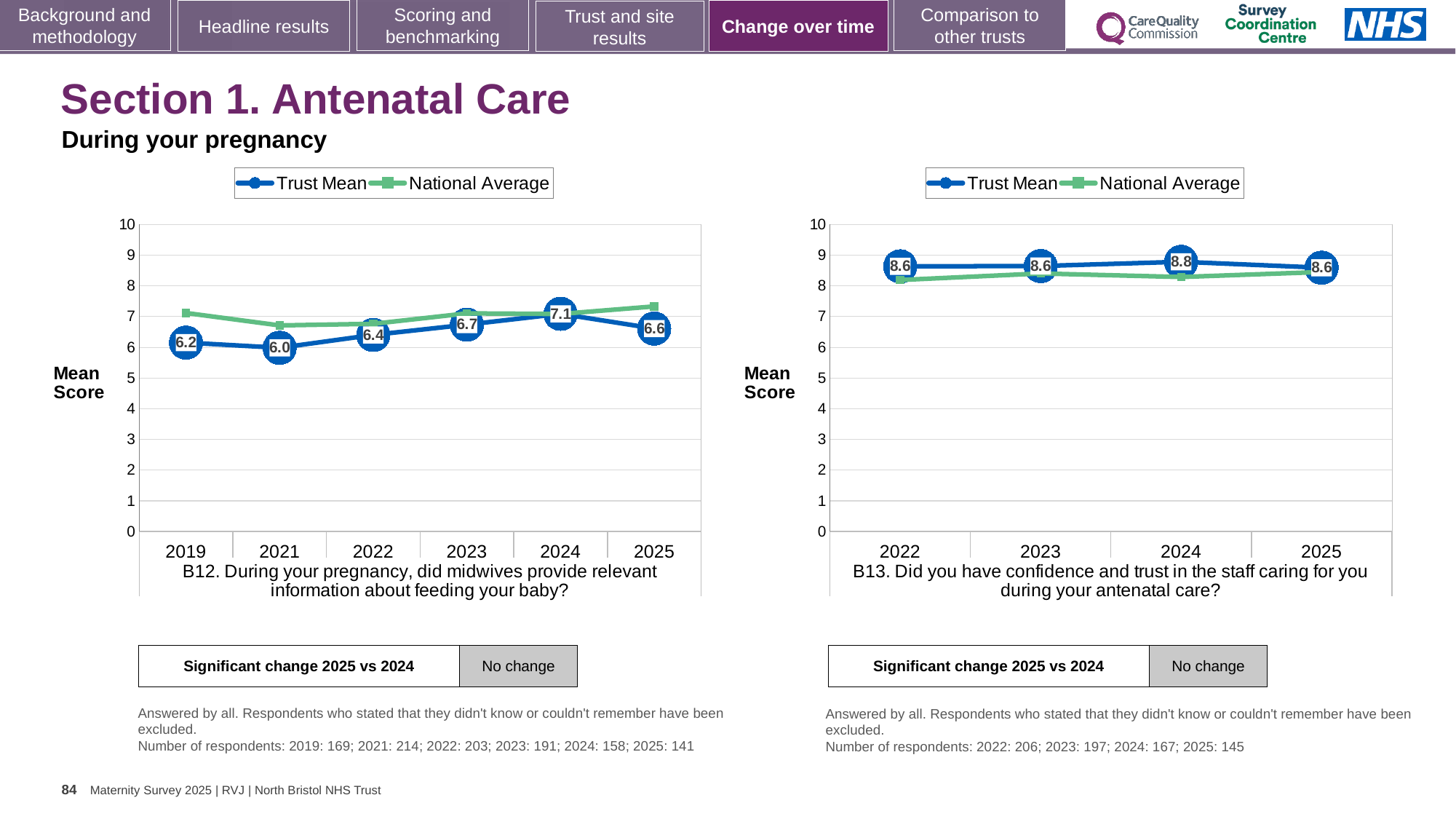
In the B13 chart (right), is the National Average for 2022 greater or less than 9? less In the B13 chart (right), which year has the highest Trust Mean score? 2024 In the B12 chart (left), what is the Trust Mean score for 2024? 7.1 In the B13 chart (right), how many series does the legend list? 2 In the B12 chart (left), what is the Trust Mean score for 2021? 6.0 In the B12 chart (left), is the National Average for 2019 greater or less than 6? greater In the B13 chart (right), what is the Trust Mean score for 2024? 8.8 In the B12 chart (left), how many years are shown on the x axis? 6 What kind of chart is the B13 chart (right)? Line chart In the B12 chart (left), which year has the highest Trust Mean score? 2024 In the B12 chart (left), which year has the lowest Trust Mean score? 2021 In the B12 chart (left), what is the difference between the Trust Mean scores for 2024 and 2025? 0.5